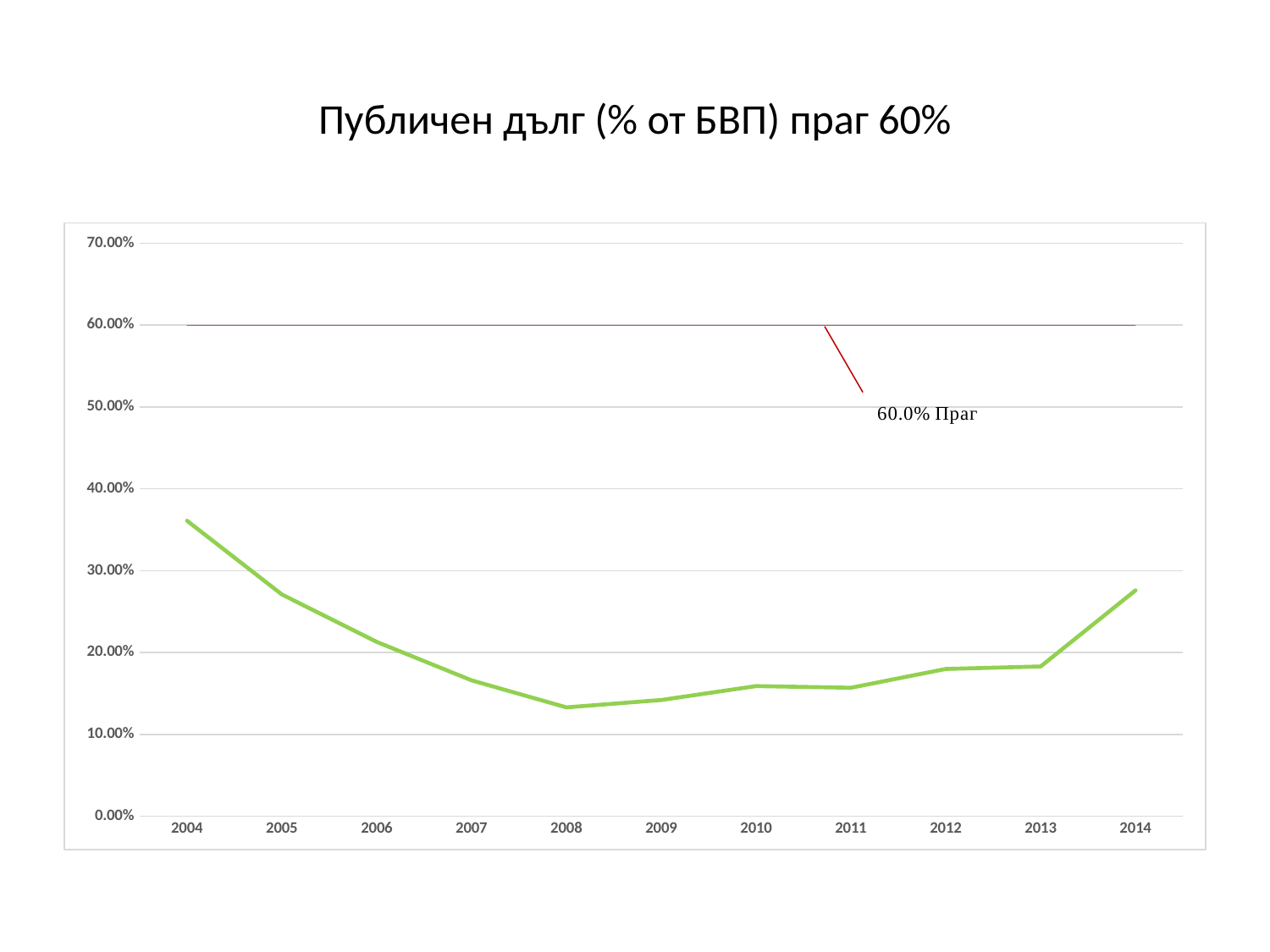
How many years are plotted along the x axis? 11 Which year has the larger value, 2004 or 2014? 2004 In which year is the public debt (% of GDP) lowest? 2008 What threshold value does the red horizontal line mark, according to its label? 60.0% What kind of chart is shown on the slide? line chart What is the title of the chart? Публичен дълг (% от БВП) праг 60% Is the value for 2004 greater or less than 30.00%? greater Is the value for 2008 greater or less than 10.00%? greater Do the values rise or fall from 2004 to 2008? fall In which year is the public debt (% of GDP) highest? 2004 Is the value for 2012 greater or less than 20.00%? less